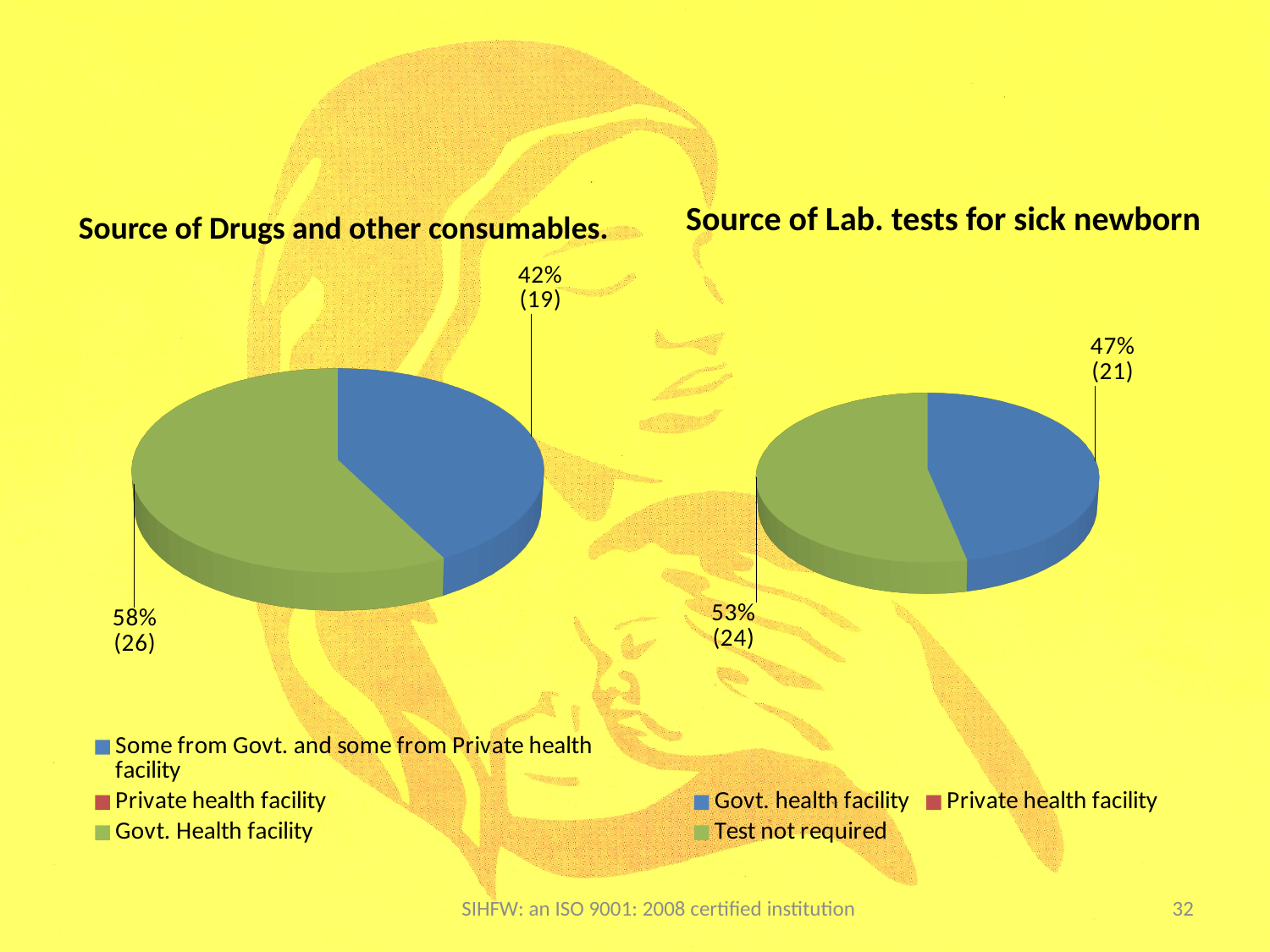
In the 'Source of Drugs and other consumables.' chart, what count is shown for 'Some from Govt. and some from Private health facility'? 19 What type of chart is used for 'Source of Drugs and other consumables.'? pie chart How many entries does the legend of the 'Source of Drugs and other consumables.' chart list? 3 In the 'Source of Lab. tests for sick newborn' chart, what share is labelled for 'Test not required'? 53% How many entries does the legend of the 'Source of Lab. tests for sick newborn' chart list? 3 What colour represents 'Govt. health facility' in the 'Source of Lab. tests for sick newborn' chart? blue In the 'Source of Drugs and other consumables.' chart, which category has the largest slice? Govt. Health facility In the 'Source of Lab. tests for sick newborn' chart, which is larger: 'Govt. health facility' or 'Test not required'? Test not required In the 'Source of Lab. tests for sick newborn' chart, what count is shown for 'Govt. health facility'? 21 In the 'Source of Drugs and other consumables.' chart, what is the difference in counts between 'Govt. Health facility' (26) and 'Some from Govt. and some from Private health facility' (19)? 7 In the 'Source of Drugs and other consumables.' chart, what share is labelled for 'Govt. Health facility'? 58% In the 'Source of Lab. tests for sick newborn' chart, what is the difference in counts between 'Test not required' (24) and 'Govt. health facility' (21)? 3